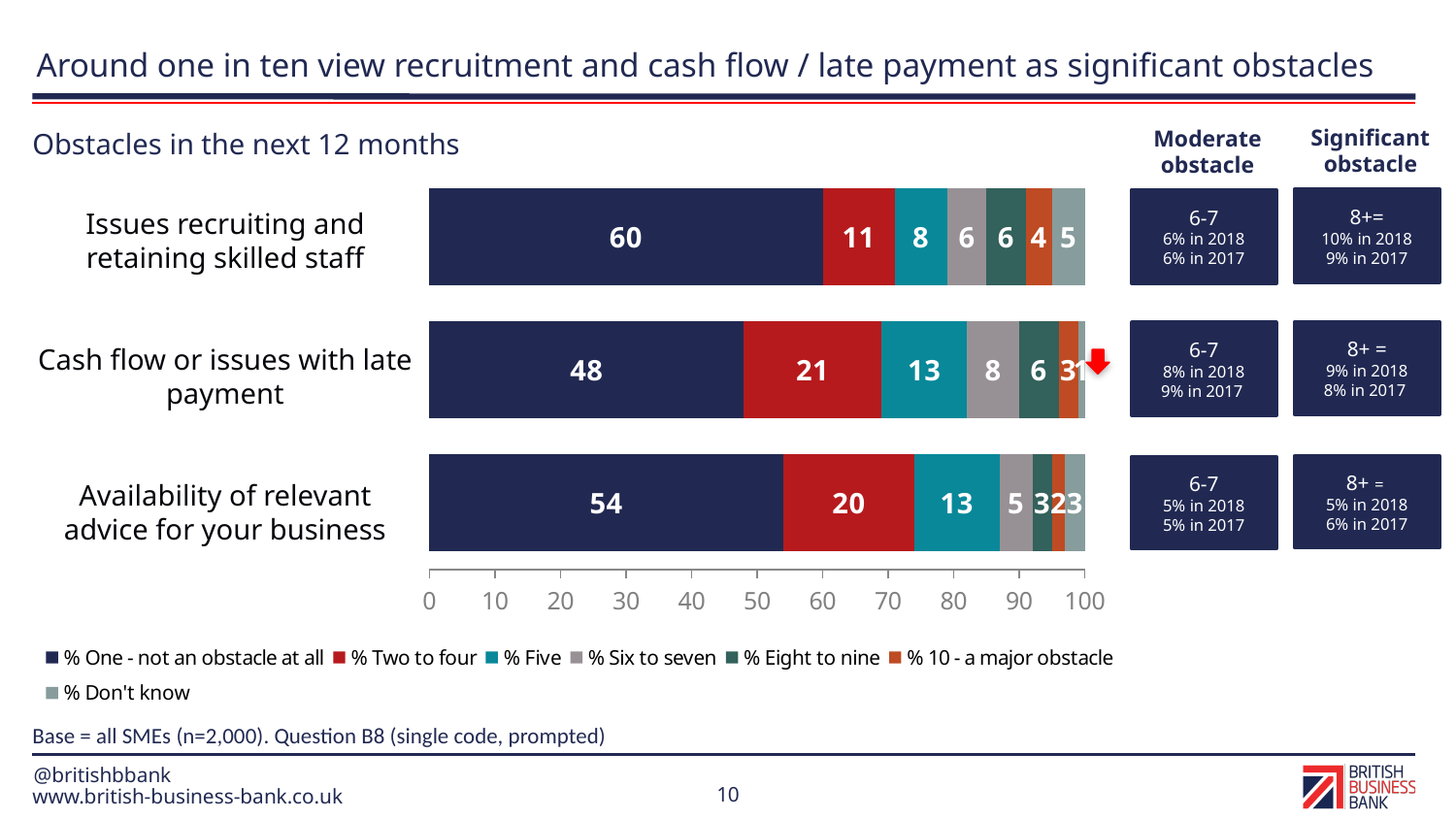
How many categories (obstacles) are plotted in the chart? 3 What is the value of '% Five' for 'Availability of relevant advice for your business'? 13 What is the title of the chart? Obstacles in the next 12 months What kind of chart is shown on the slide? Bar chart Which has the larger '% Two to four' value: 'Cash flow or issues with late payment' or 'Issues recruiting and retaining skilled staff'? Cash flow or issues with late payment Which category has the highest value for '% One - not an obstacle at all'? Issues recruiting and retaining skilled staff What is the value of '% Six to seven' for 'Cash flow or issues with late payment'? 8 How many series does the legend list? 7 What is the value of '% One - not an obstacle at all' for 'Issues recruiting and retaining skilled staff'? 60 What is the value of '% Two to four' for 'Cash flow or issues with late payment'? 21 Which category has the lowest value for '% One - not an obstacle at all'? Cash flow or issues with late payment What is the difference between the '% One - not an obstacle at all' values for 'Issues recruiting and retaining skilled staff' and 'Cash flow or issues with late payment'? 12